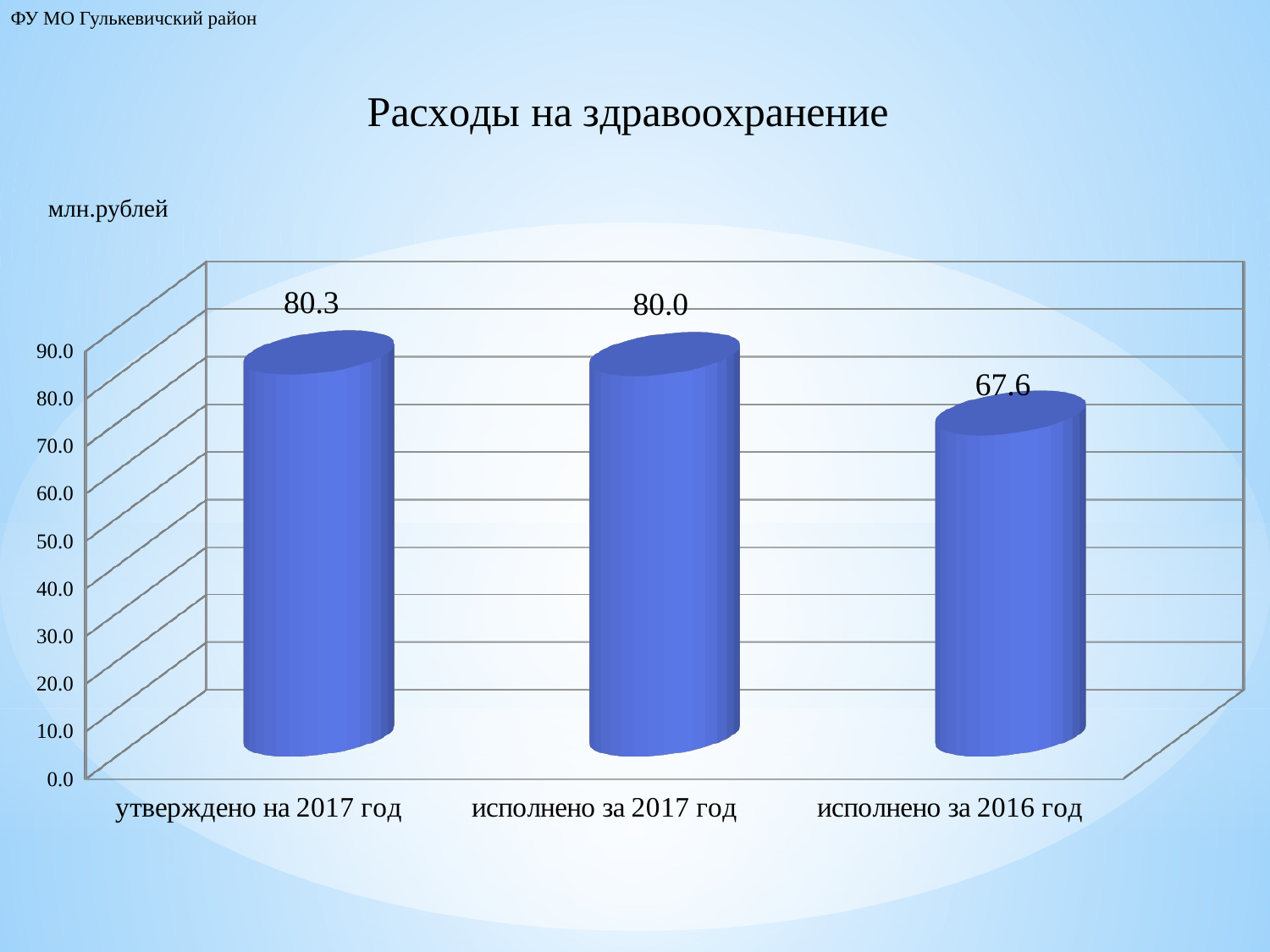
What is the value for 'утверждено на 2017 год'? 80.3 What is the title of the chart? Расходы на здравоохранение Is the value for 'исполнено за 2016 год' greater or less than 70.0? less What kind of chart is shown on the slide? bar chart What unit is indicated for the values in the chart? млн.рублей Which is larger: 'исполнено за 2017 год' or 'исполнено за 2016 год'? исполнено за 2017 год Which category has the lowest value? исполнено за 2016 год What is the value for 'исполнено за 2017 год'? 80.0 What is the difference between 'утверждено на 2017 год' and 'исполнено за 2016 год'? 12.7 How many categories are shown in the chart? 3 What is the difference between 'исполнено за 2017 год' and 'исполнено за 2016 год'? 12.4 What is the value for 'исполнено за 2016 год'? 67.6